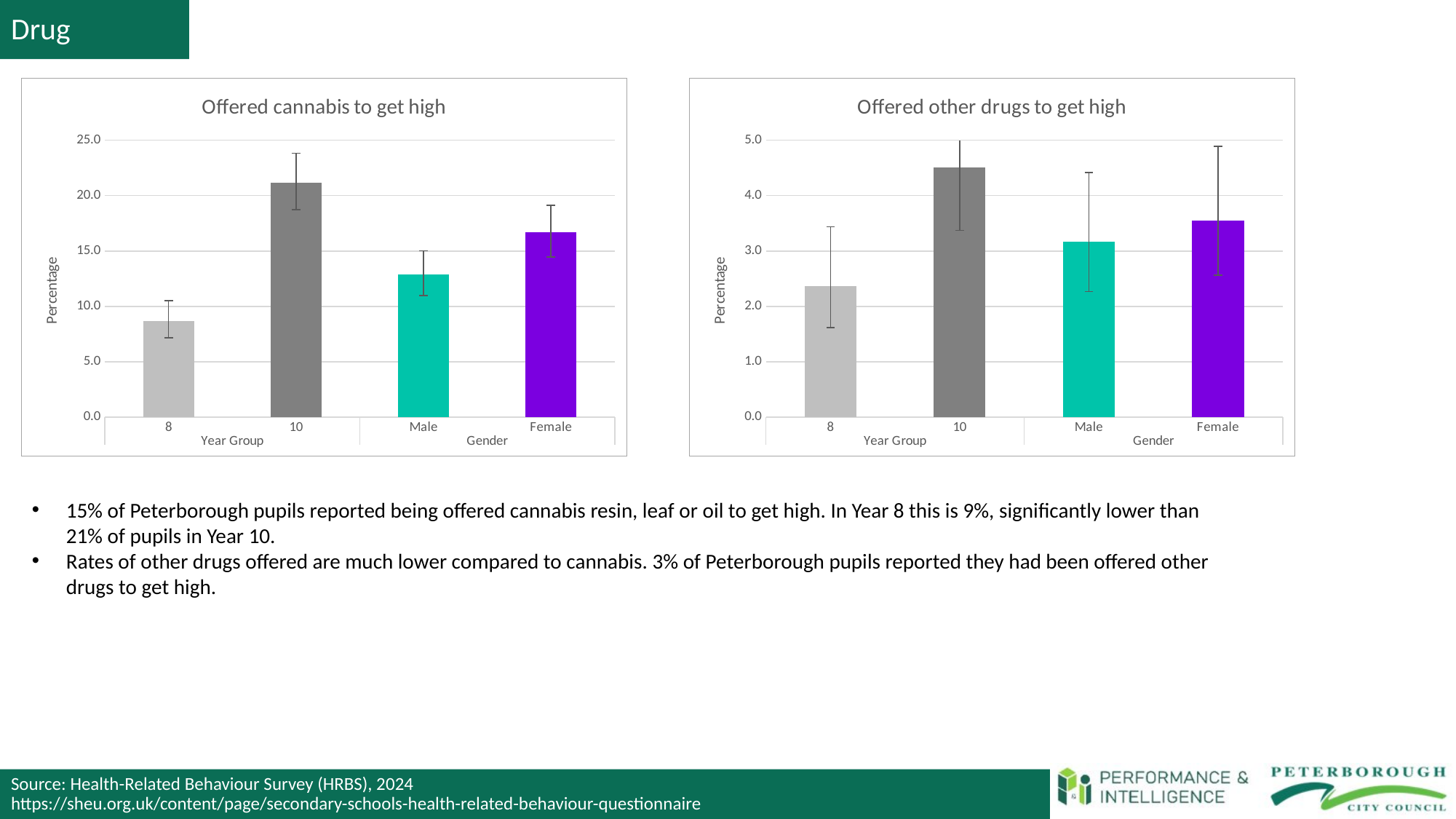
In the 'Offered cannabis to get high' chart, which category has the lowest value? 8 In the 'Offered other drugs to get high' chart, which category has the highest value? 10 In the 'Offered other drugs to get high' chart, which category has the lowest value? 8 In the 'Offered cannabis to get high' chart, which is larger, the value for Male or the value for Female? Female In the 'Offered cannabis to get high' chart, how many categories are plotted? 4 What is the label on the vertical axis of the 'Offered other drugs to get high' chart? Percentage In the 'Offered cannabis to get high' chart, is the value for Year Group 10 greater or less than 20.0? greater In the 'Offered cannabis to get high' chart, which category has the highest value? 10 In the 'Offered cannabis to get high' chart, is the value for Year Group 8 greater or less than 10.0? less What kind of chart is the 'Offered cannabis to get high' chart? bar chart In the 'Offered other drugs to get high' chart, is the value for Year Group 10 greater or less than 4.0? greater